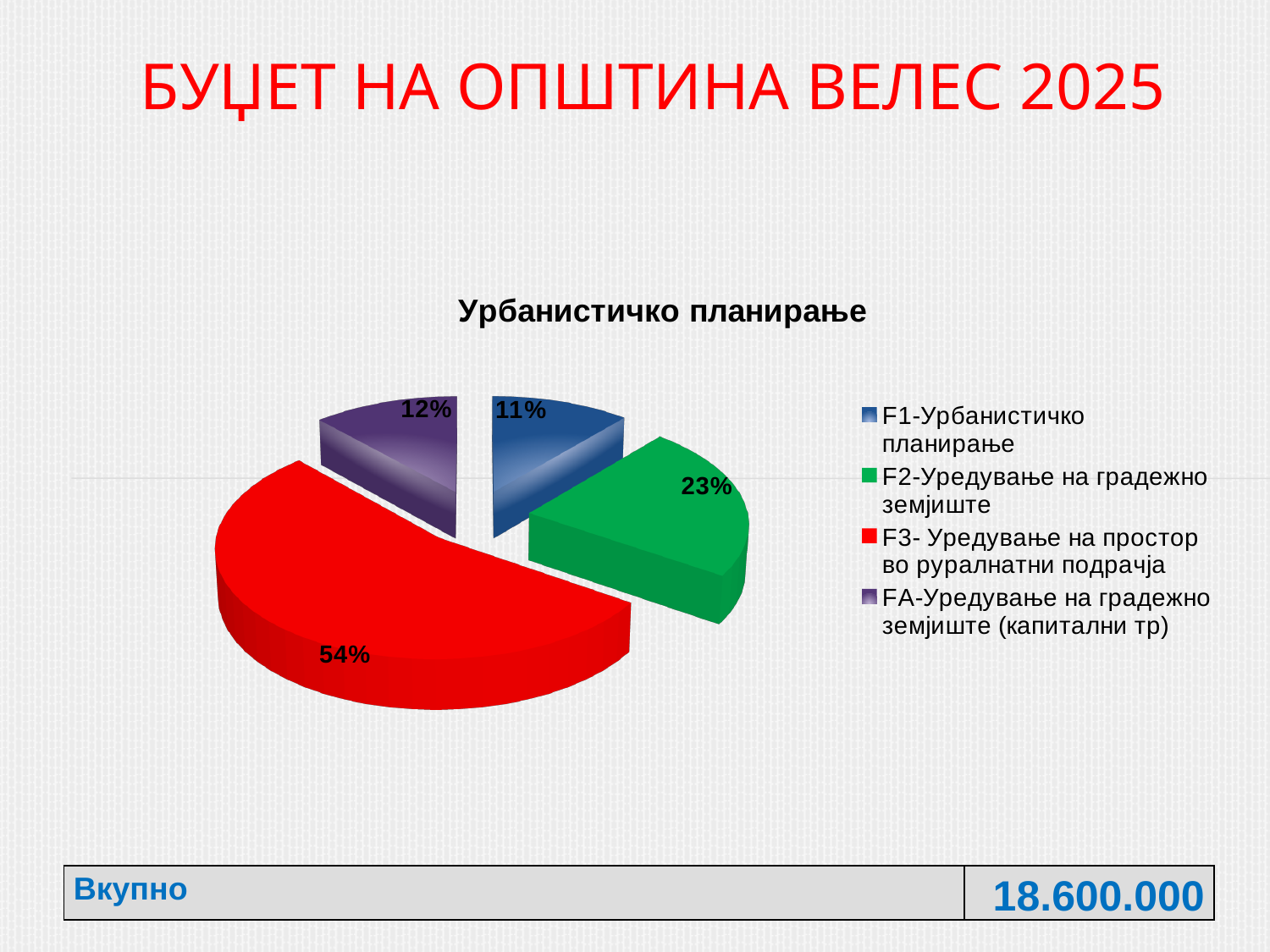
What share of the pie does F3- Уредување на простор во руралнатни подрачја have? 54% Which category has the largest slice of the pie? F3- Уредување на простор во руралнатни подрачја What is the difference in percentage points between the F3 slice and the F2 slice? 31 What share of the pie does FA-Уредување на градежно земјиште (капитални тр) have? 12% What is the title of the chart? Урбанистичко планирање What share of the pie does F2-Уредување на градежно земјиште have? 23% Which category has the smallest slice of the pie? F1-Урбанистичко планирање Which colour is used for the F3- Уредување на простор во руралнатни подрачја slice? red How many slices does the pie chart have? 4 What kind of chart is shown on the slide? pie chart How many entries does the legend list? 4